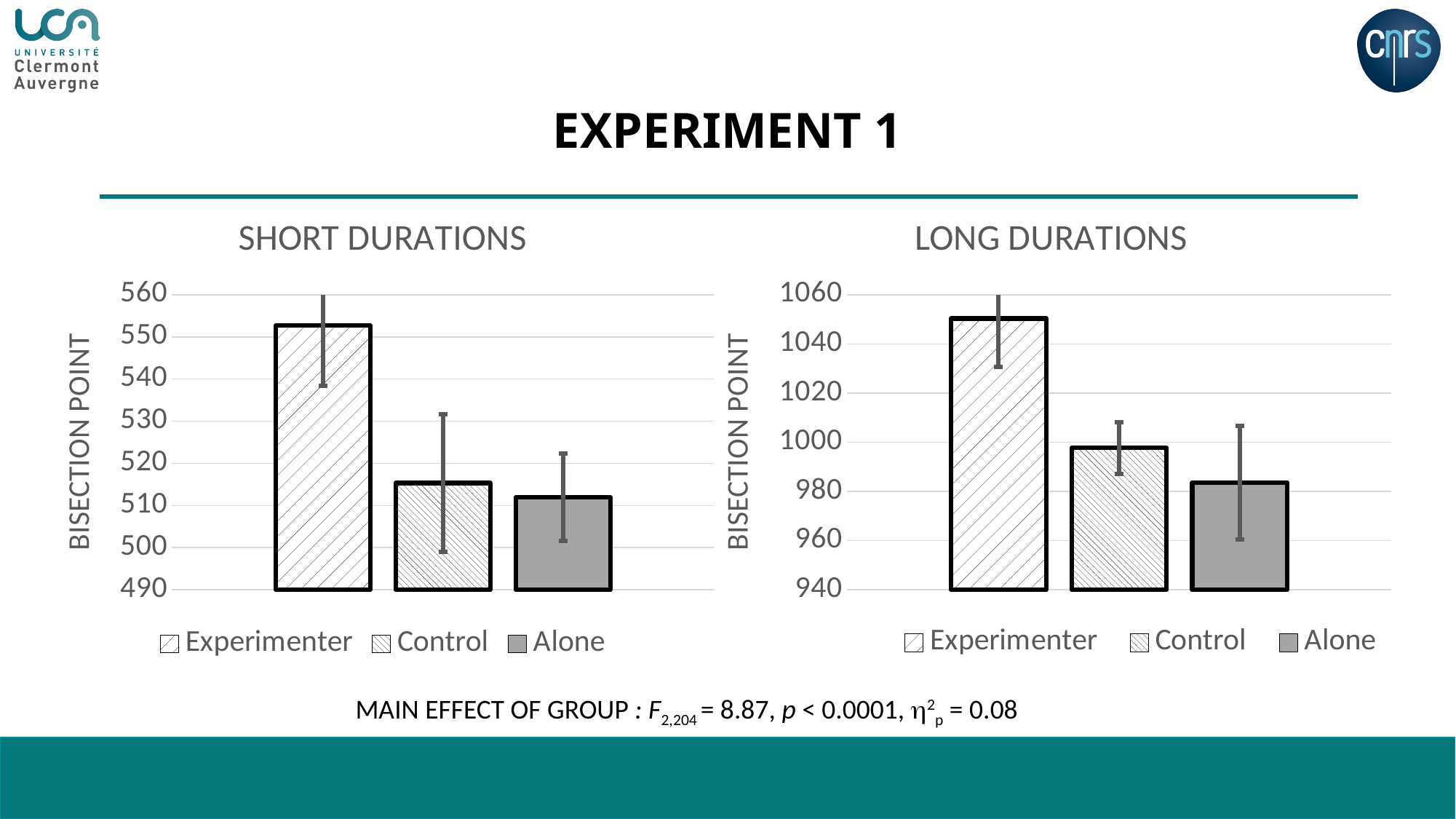
In the LONG DURATIONS chart, which group has the lowest bisection point? Alone In the LONG DURATIONS chart, is the value for Control greater or less than 980? greater What is the y-axis label of the SHORT DURATIONS chart? BISECTION POINT In the SHORT DURATIONS chart, is the value for Experimenter greater or less than 540? greater In the LONG DURATIONS chart, is the value for Alone greater or less than 1000? less In the SHORT DURATIONS chart, which group has the highest bisection point? Experimenter What kind of chart is the LONG DURATIONS chart? bar chart In the LONG DURATIONS chart, which is larger, the value for Control or the value for Alone? Control In the LONG DURATIONS chart, which group has the highest bisection point? Experimenter How many groups are plotted in the SHORT DURATIONS chart? 3